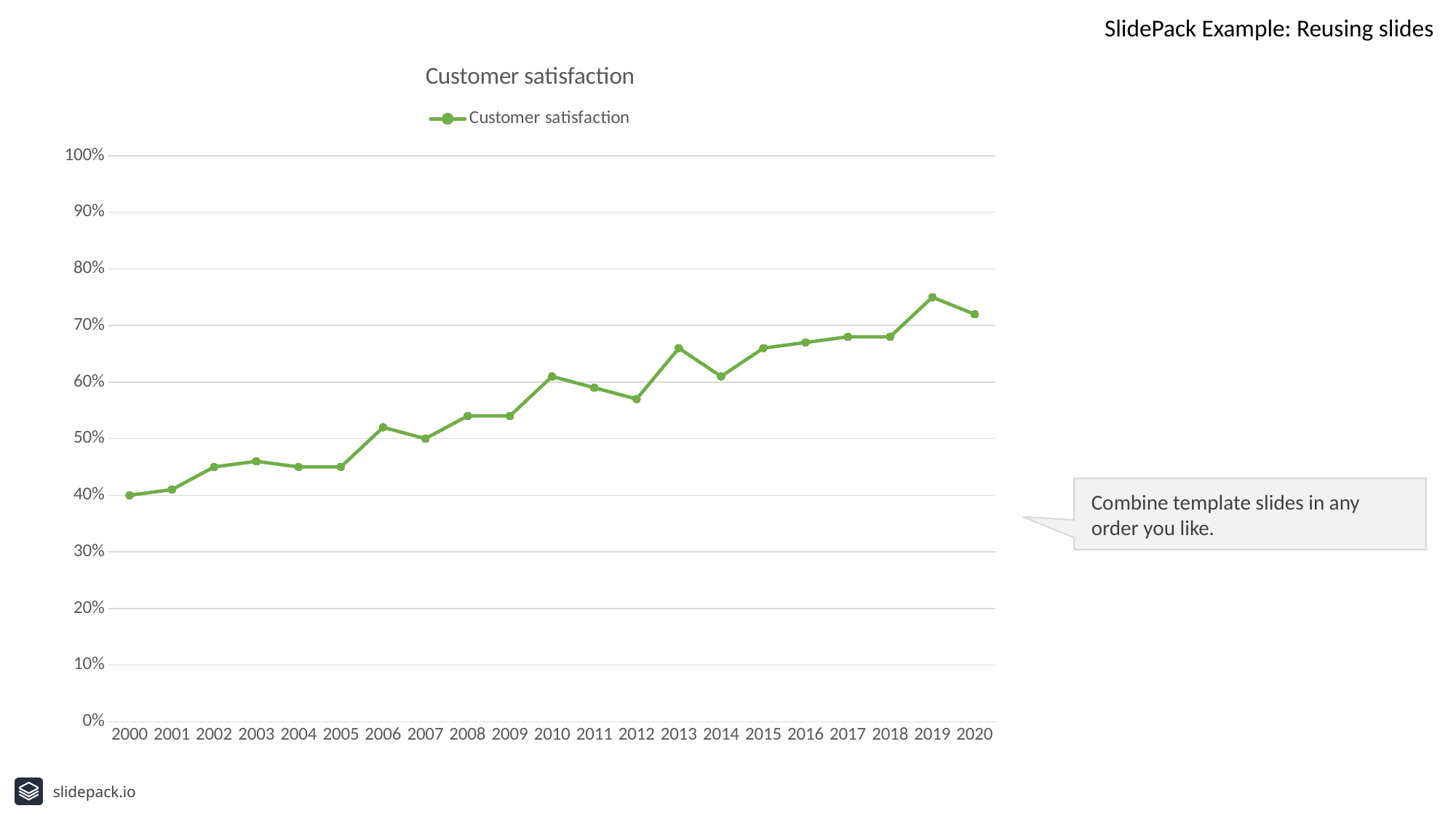
Which year has the larger value, 2013 or 2014? 2013 Which year has the highest customer satisfaction value? 2019 Is the value for 2003 greater or less than 50%? less Overall, do the values rise or fall from 2000 to 2020? rise What is the title of the chart? Customer satisfaction How many years are plotted along the x axis? 21 How many series does the legend list? 1 Is the value for 2019 greater or less than 70%? greater Is the value for 2012 greater or less than 60%? less What type of chart is shown on the slide? line chart Which year has the lowest customer satisfaction value? 2000 What is the customer satisfaction value for 2000? 40%